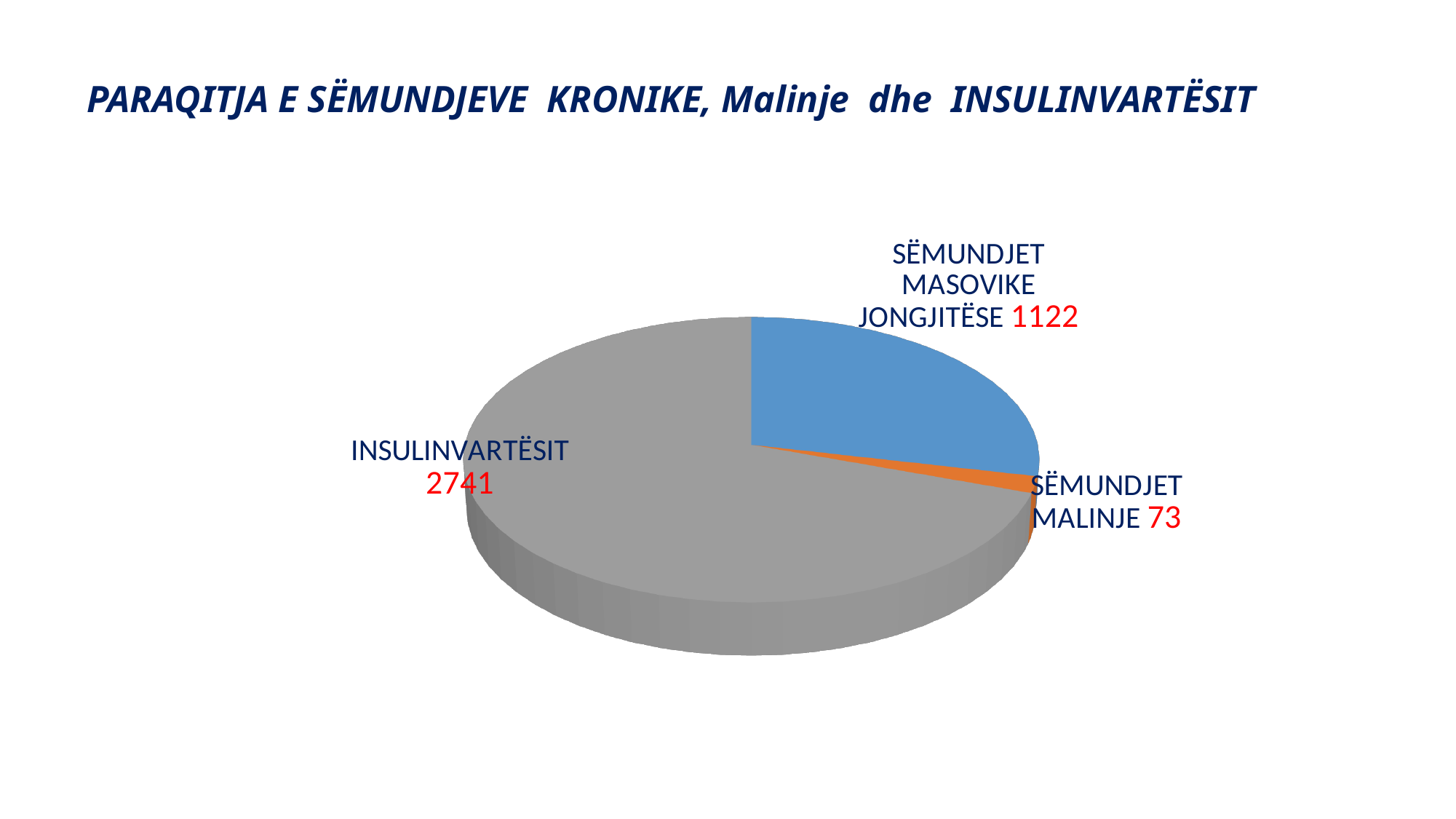
What value is shown for SËMUNDJET MALINJE? 73 Which is larger, the value for SËMUNDJET MASOVIKE JONGJITËSE or the value for SËMUNDJET MALINJE? SËMUNDJET MASOVIKE JONGJITËSE What colour is the slice for SËMUNDJET MASOVIKE JONGJITËSE? Blue What kind of chart is shown on the slide? Pie chart Which category has the smallest slice of the pie? SËMUNDJET MALINJE What value is shown for INSULINVARTËSIT? 2741 What is the difference between the values for INSULINVARTËSIT and SËMUNDJET MASOVIKE JONGJITËSE? 1619 How many categories are shown in the pie chart? 3 What is the difference between the values for SËMUNDJET MASOVIKE JONGJITËSE and SËMUNDJET MALINJE? 1049 What value is shown for SËMUNDJET MASOVIKE JONGJITËSE? 1122 What is the total of all three values in the pie chart? 3936 Which category has the largest slice of the pie? INSULINVARTËSIT